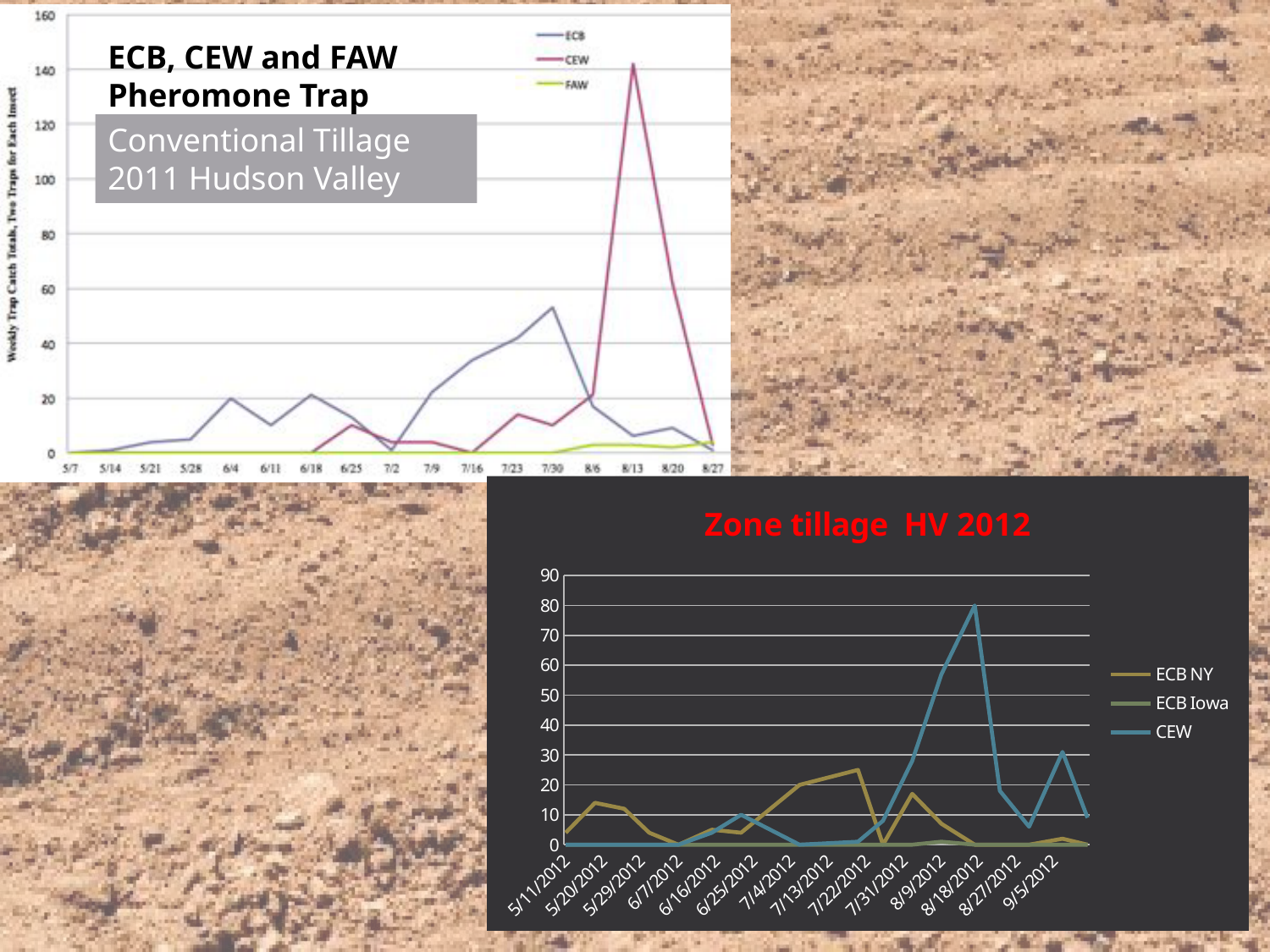
In the 'Zone tillage HV 2012' chart, at 8/18/2012, which is larger: CEW or ECB NY? CEW What is the title of the chart in the lower right of the slide? Zone tillage HV 2012 How many series does the legend of the 'ECB, CEW and FAW Pheromone Trap' chart list? 3 In the 'Zone tillage HV 2012' chart, which series reaches the highest value? CEW What kind of chart is the 'Zone tillage HV 2012' chart? line chart In the 'ECB, CEW and FAW Pheromone Trap' chart, at 7/30, which is larger: ECB or CEW? ECB How many series does the legend of the 'Zone tillage HV 2012' chart list? 3 In the 'Zone tillage HV 2012' chart, is the CEW value at 8/18/2012 greater or less than 60? greater In the 'ECB, CEW and FAW Pheromone Trap' chart, is the CEW value at 8/13 greater or less than 120? greater In the 'ECB, CEW and FAW Pheromone Trap' chart, which series reaches the highest value? CEW In the 'Zone tillage HV 2012' chart, does the CEW line rise or fall from 8/18/2012 to 8/27/2012? fall In the 'ECB, CEW and FAW Pheromone Trap' chart, is the ECB value at 7/30 greater or less than 40? greater